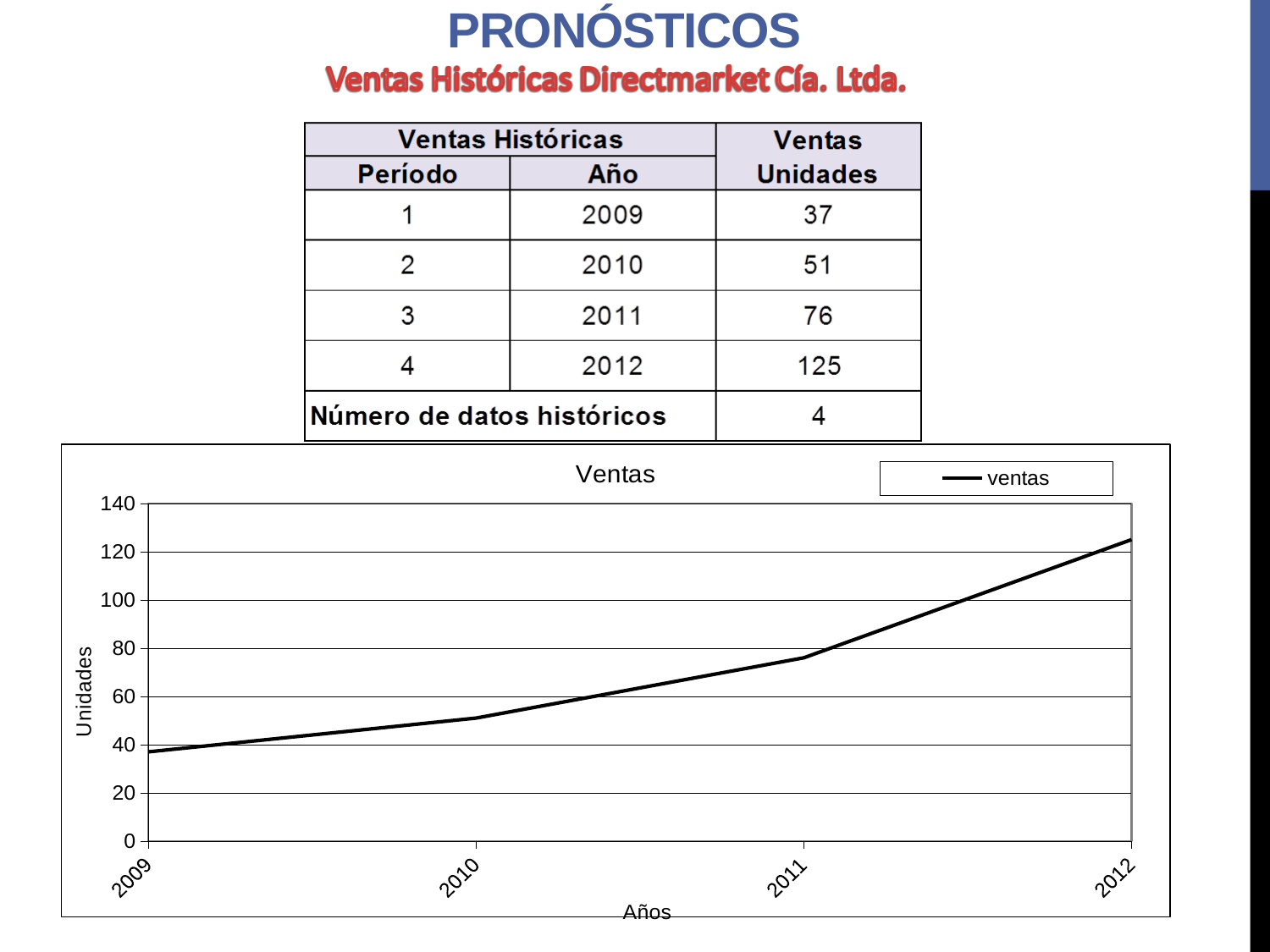
Which year has the highest sales? 2012 What kind of chart is shown on the slide? line chart What is the difference in units between sales in 2012 and sales in 2011? 49 What is the label of the y axis of the chart? Unidades Do the sales values rise or fall from 2009 to 2012? rise What is the sales value in units for 2012? 125 How many years are plotted on the x axis of the chart? 4 Is the value for 2011 greater or less than 80? less What is the sales value in units for 2009? 37 How many series does the chart legend list? 1 Which year has the lowest sales? 2009 What is the title of the chart? Ventas